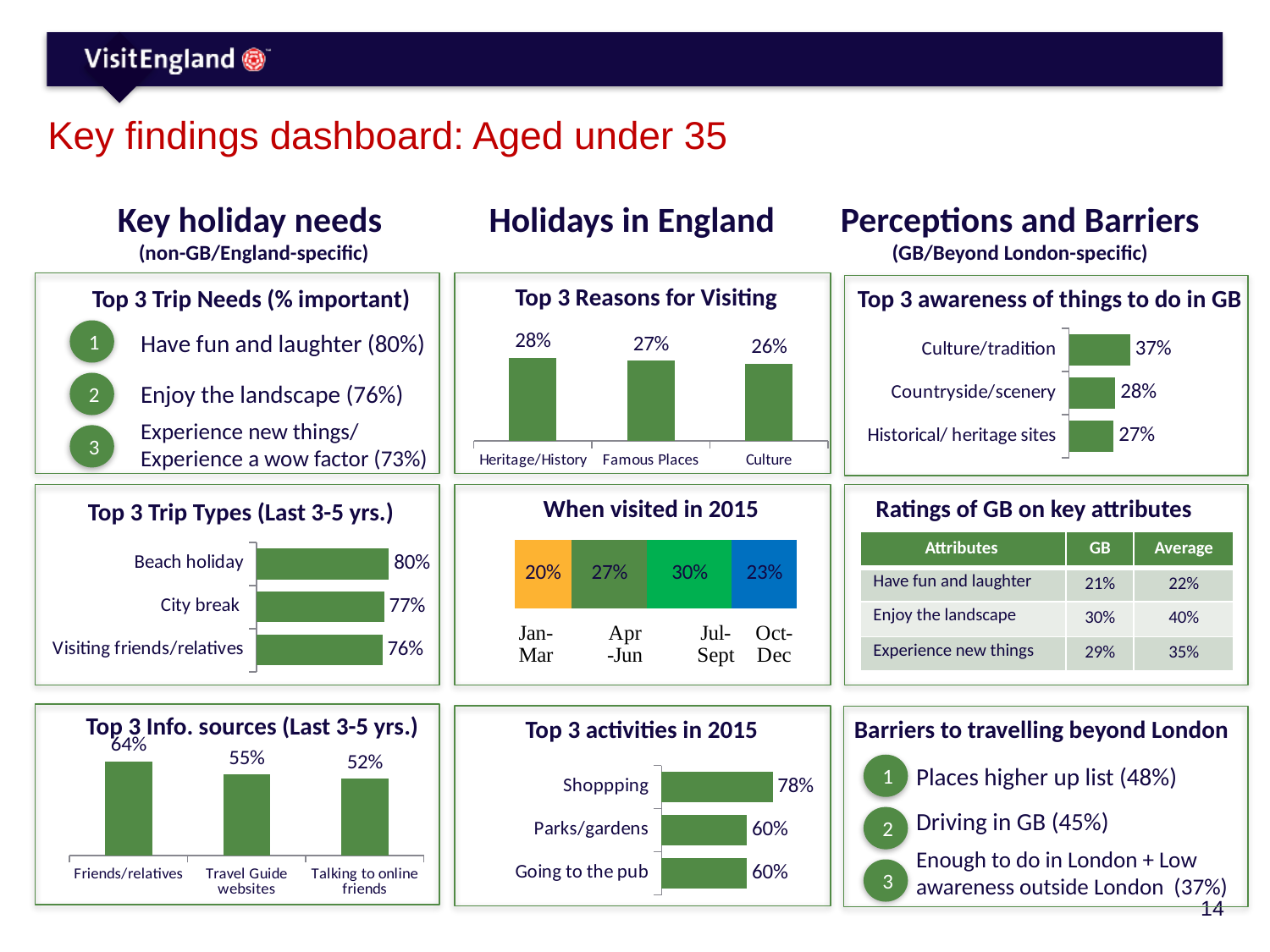
In the 'Top 3 Trip Types (Last 3-5 yrs.)' chart, which category has the highest value? Beach holiday In the 'Top 3 awareness of things to do in GB' chart, what is the value for Culture/tradition? 37% In the 'Top 3 awareness of things to do in GB' chart, what is the difference between Culture/tradition and Historical/ heritage sites? 10% In the 'Top 3 Info. sources (Last 3-5 yrs.)' chart, do the values rise or fall from left to right? fall In the 'Top 3 Reasons for Visiting' chart, which category has the lowest value? Culture In the 'When visited in 2015' chart, how many segments are shown? 4 In the 'Top 3 Reasons for Visiting' chart, what is the value for Heritage/History? 28% In the 'Top 3 activities in 2015' chart, what is the value for Shoppping? 78% In the 'Top 3 Info. sources (Last 3-5 yrs.)' chart, what is the value for Travel Guide websites? 55% In the 'Top 3 Trip Types (Last 3-5 yrs.)' chart, what is the value for City break? 77% In the 'When visited in 2015' chart, what is the value for Jul-Sept? 30% What kind of chart is the 'Top 3 activities in 2015' chart? bar chart